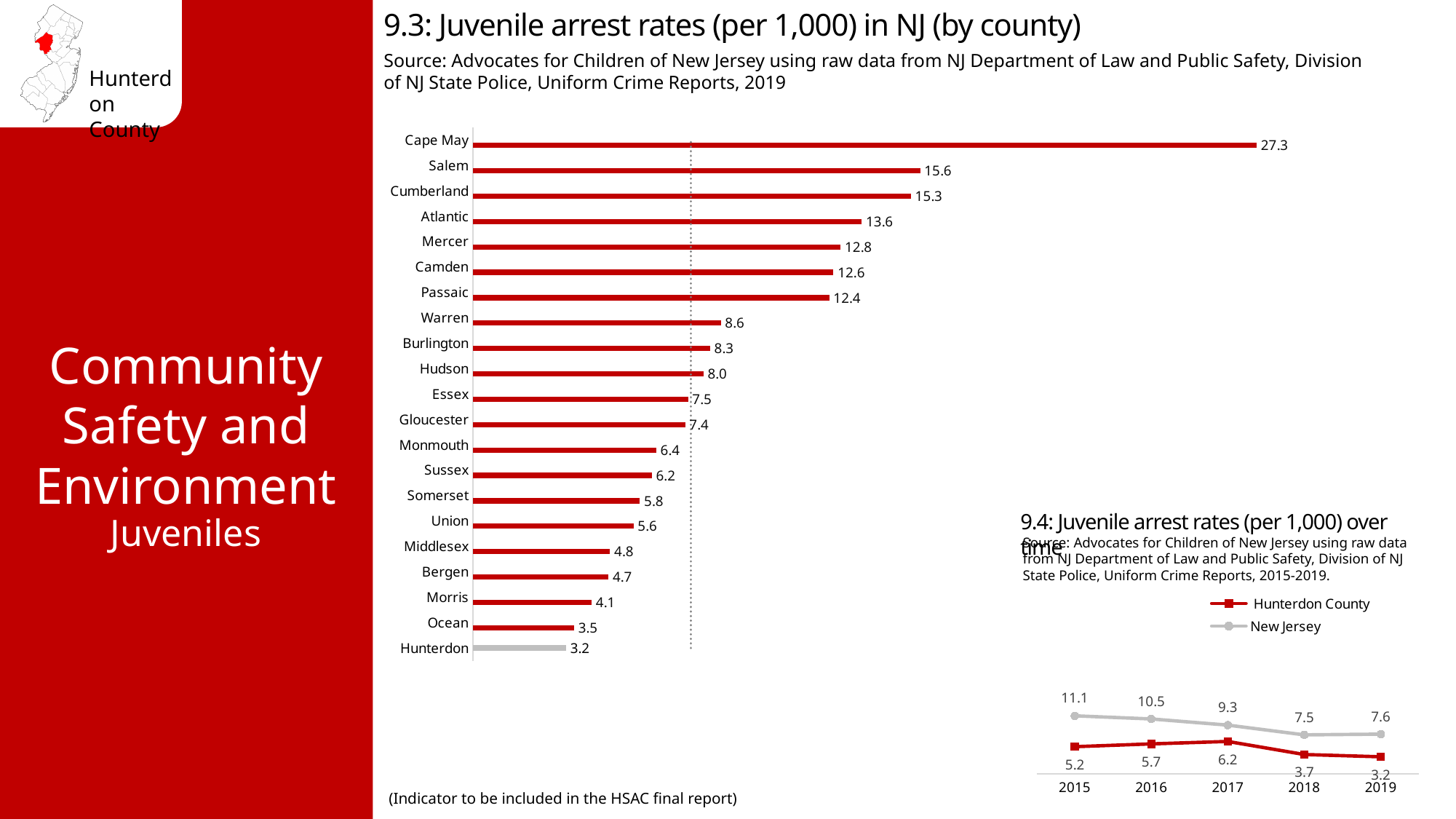
In the chart '9.4: Juvenile arrest rates (per 1,000) over time', what is the difference between the New Jersey and Hunterdon County values in 2019? 4.4 How many counties are shown in the chart '9.3: Juvenile arrest rates (per 1,000) in NJ (by county)'? 21 In the chart '9.3: Juvenile arrest rates (per 1,000) in NJ (by county)', what is the value for Cape May? 27.3 In the chart '9.3: Juvenile arrest rates (per 1,000) in NJ (by county)', what is the value for Hunterdon? 3.2 What kind of chart is '9.3: Juvenile arrest rates (per 1,000) in NJ (by county)'? Bar chart In the chart '9.4: Juvenile arrest rates (per 1,000) over time', what is the value for New Jersey in 2015? 11.1 In the chart '9.3: Juvenile arrest rates (per 1,000) in NJ (by county)', which county has the highest value? Cape May In the chart '9.4: Juvenile arrest rates (per 1,000) over time', what is the value for Hunterdon County in 2017? 6.2 How many series does the legend list in the chart '9.4: Juvenile arrest rates (per 1,000) over time'? 2 In the chart '9.3: Juvenile arrest rates (per 1,000) in NJ (by county)', which has a larger value, Warren or Monmouth? Warren In the chart '9.3: Juvenile arrest rates (per 1,000) in NJ (by county)', what is the difference between the values for Salem and Cumberland? 0.3 In the chart '9.3: Juvenile arrest rates (per 1,000) in NJ (by county)', which county has the lowest value? Hunterdon